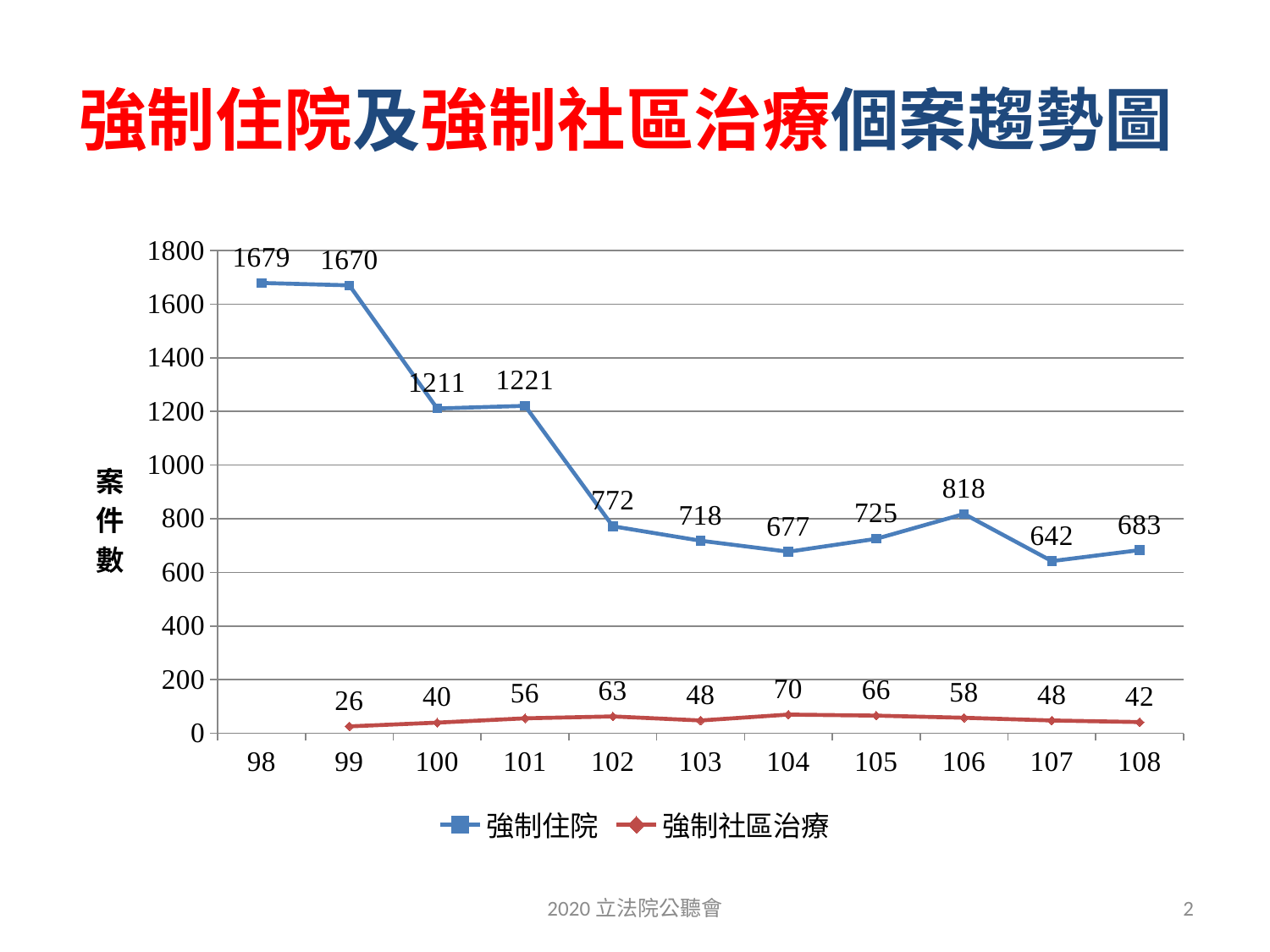
In which year is 強制社區治療 at its highest? 104 How many years are shown on the x axis? 11 How many series does the legend list? 2 What is the label on the y axis? 案件數 Does the 強制住院 series generally rise or fall from year 98 to year 108? fall What kind of chart is this? line chart What is the value for 強制住院 in year 98? 1679 Which is larger, the 強制住院 value in year 105 or in year 108? 105 What is the value for 強制社區治療 in year 104? 70 In which year is 強制住院 at its lowest? 107 What is the difference between the 強制住院 values for years 99 and 100? 459 What is the value for 強制住院 in year 106? 818